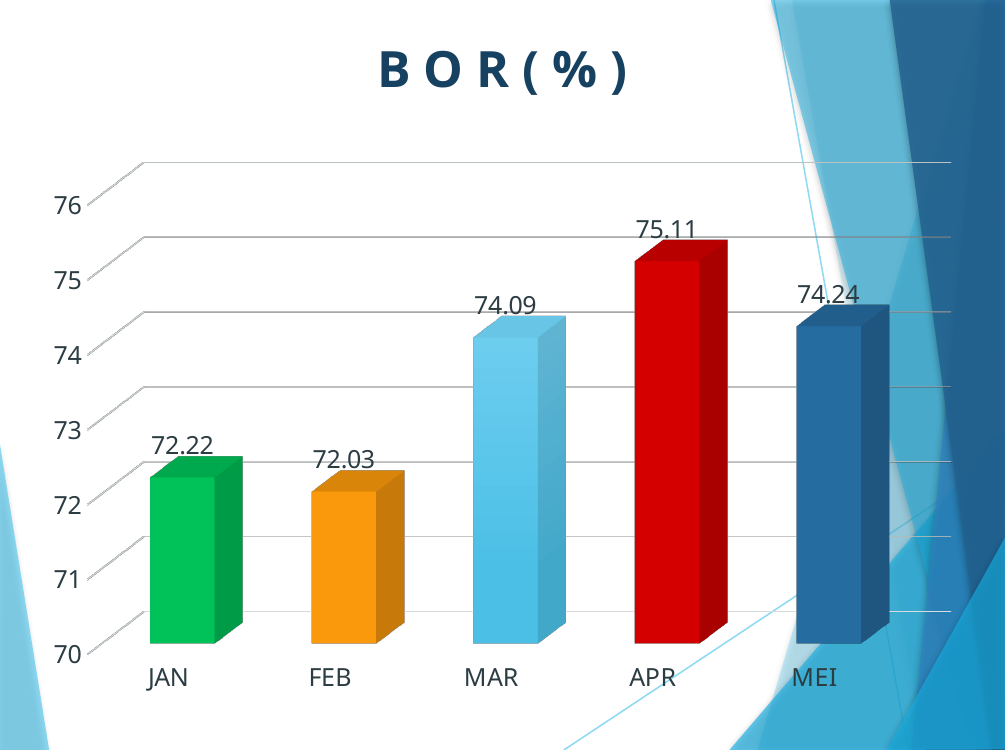
What is the BOR (%) value for JAN? 72.22 What is the title of the chart? BOR(%) What kind of chart is shown on the slide? bar chart What is the difference between the BOR (%) values for MEI and MAR? 0.15 What is the BOR (%) value for MAR? 74.09 Which has a higher BOR (%), JAN or FEB? JAN Which month has the lowest BOR (%)? FEB Is the BOR (%) value for APR greater or less than 75? greater Which month has the highest BOR (%)? APR How many months are shown on the chart? 5 What is the difference between the BOR (%) values for APR and FEB? 3.08 What is the BOR (%) value for MEI? 74.24